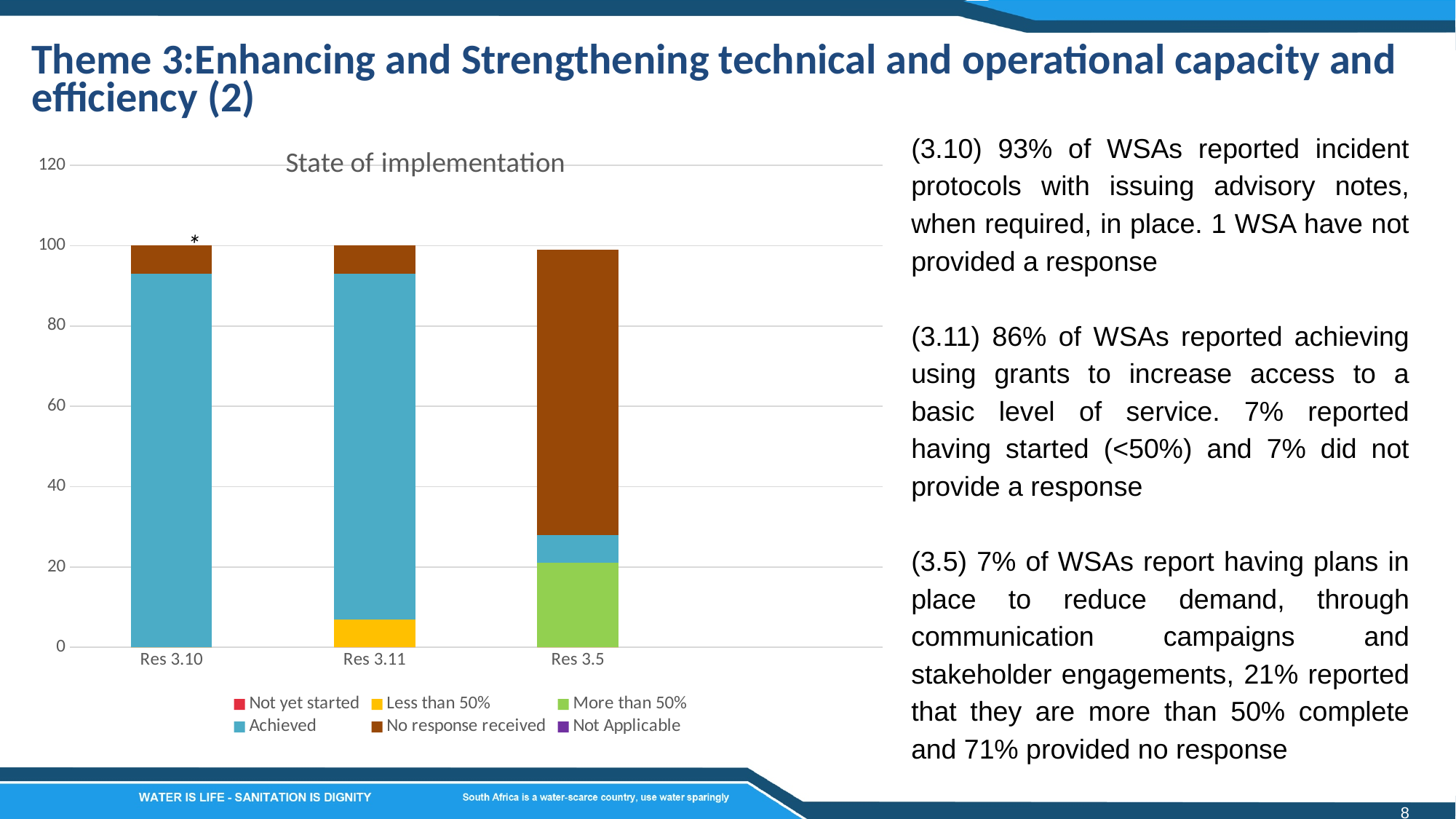
What kind of chart is shown on the slide? Stacked bar chart Which category on the x axis is marked with an asterisk above its bar? Res 3.10 Is the 'No response received' value for Res 3.5 greater or less than 60? greater Is the 'Less than 50%' value for Res 3.11 greater or less than 20? less Which category has the largest 'No response received' segment? Res 3.5 How many series does the chart's legend list? 6 Which category has the largest 'More than 50%' segment? Res 3.5 What is the title of the chart? State of implementation Which is larger, the 'Achieved' value for Res 3.10 or for Res 3.5? Res 3.10 How many categories are shown on the x axis of the chart? 3 Is the 'More than 50%' value for Res 3.5 greater or less than 40? less